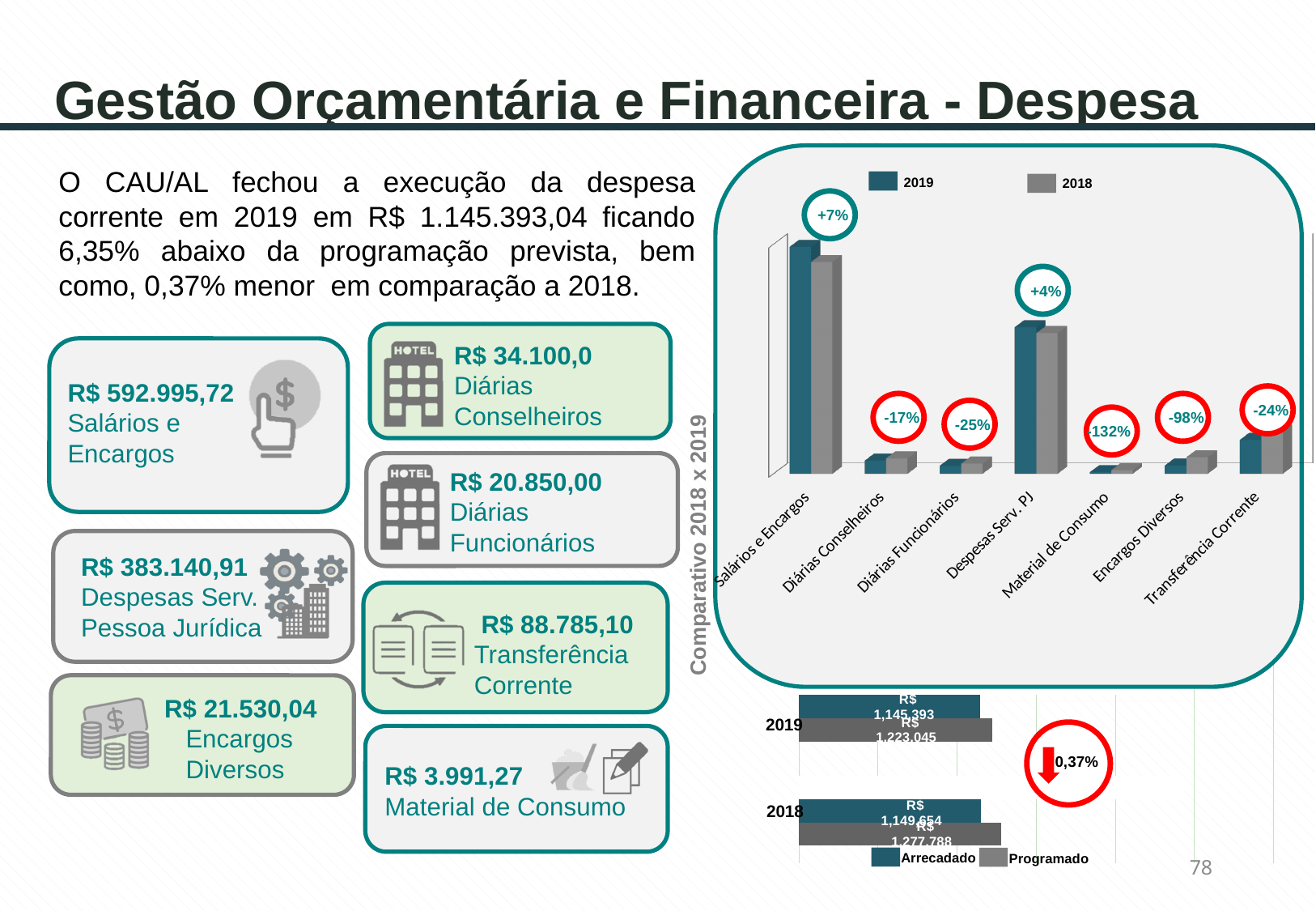
In the 'Comparativo 2018 x 2019' chart, how many expense categories are shown on the x axis? 7 In the bottom chart (Arrecadado vs Programado), what is the Arrecadado value for 2019? R$ 1,145,393 In the 'Comparativo 2018 x 2019' chart, which category has the lowest bars? Material de Consumo In the 'Comparativo 2018 x 2019' chart, what percentage change is shown above Salários e Encargos? +7% In the 'Comparativo 2018 x 2019' chart, how many series does the legend list? 2 In the bottom chart (Arrecadado vs Programado), what is the Programado value for 2018? R$ 1,277,788 In the 'Comparativo 2018 x 2019' chart, what percentage change is shown above Encargos Diversos? -98% In the 'Comparativo 2018 x 2019' chart, which is larger, the bar for Salários e Encargos or the bar for Despesas Serv. PJ? Salários e Encargos In the 'Comparativo 2018 x 2019' chart, which category has the highest bars? Salários e Encargos What kind of chart is the 'Comparativo 2018 x 2019' chart? Bar chart In the bottom chart (Arrecadado vs Programado), what is the difference between the Programado and Arrecadado values for 2019? R$ 77,652 In the bottom chart (Arrecadado vs Programado), which is larger for 2019, Arrecadado or Programado? Programado